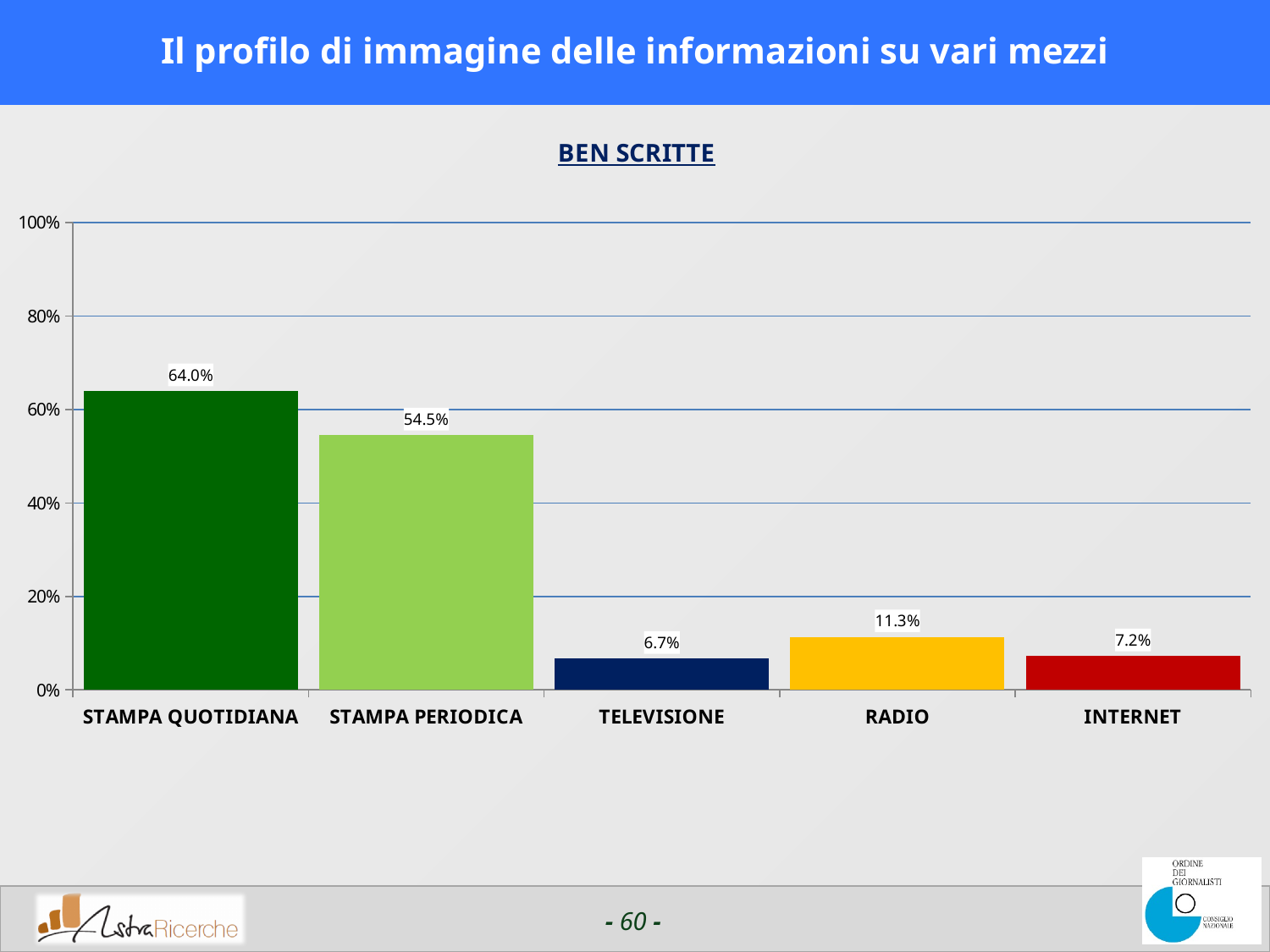
Is the value for STAMPA PERIODICA greater or less than 60%? less What is the title shown above the chart? BEN SCRITTE Which category has the highest value? STAMPA QUOTIDIANA What is the difference between the values for RADIO and INTERNET? 4.1% What is the value for TELEVISIONE? 6.7% What is the value for STAMPA QUOTIDIANA? 64.0% Which is larger, the value for RADIO or the value for INTERNET? RADIO What kind of chart is shown on the slide? bar chart Which category has the lowest value? TELEVISIONE How many categories are shown on the x axis? 5 What is the difference between the values for STAMPA QUOTIDIANA and STAMPA PERIODICA? 9.5% What is the value for RADIO? 11.3%